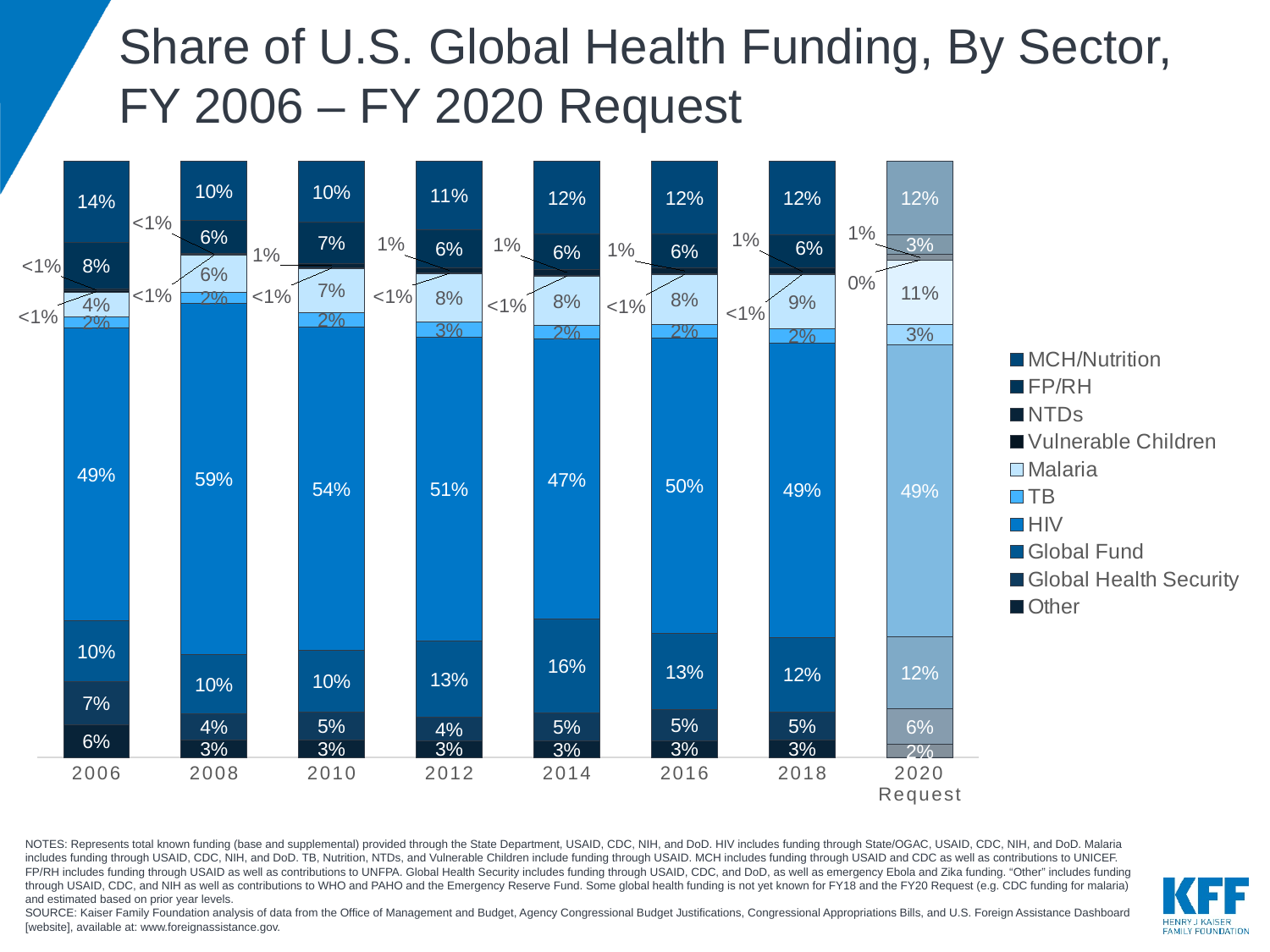
What share of funding went to the Global Fund in FY 2014? 16% In which year was the HIV share of funding highest? 2008 How many series does the legend list? 10 What share of U.S. global health funding went to HIV in FY 2008? 59% What is the title of the chart? Share of U.S. Global Health Funding, By Sector, FY 2006 – FY 2020 Request By how many percentage points does the HIV share in 2008 exceed the HIV share in 2014? 12 percentage points Which year had a larger HIV share, 2010 or 2012? 2010 In which year was the Global Fund share of funding highest? 2014 What kind of chart is shown on the slide? Stacked bar chart In which year was the HIV share of funding lowest? 2014 What share of funding went to MCH/Nutrition in FY 2006? 14% How many fiscal year categories are shown along the x axis? 8